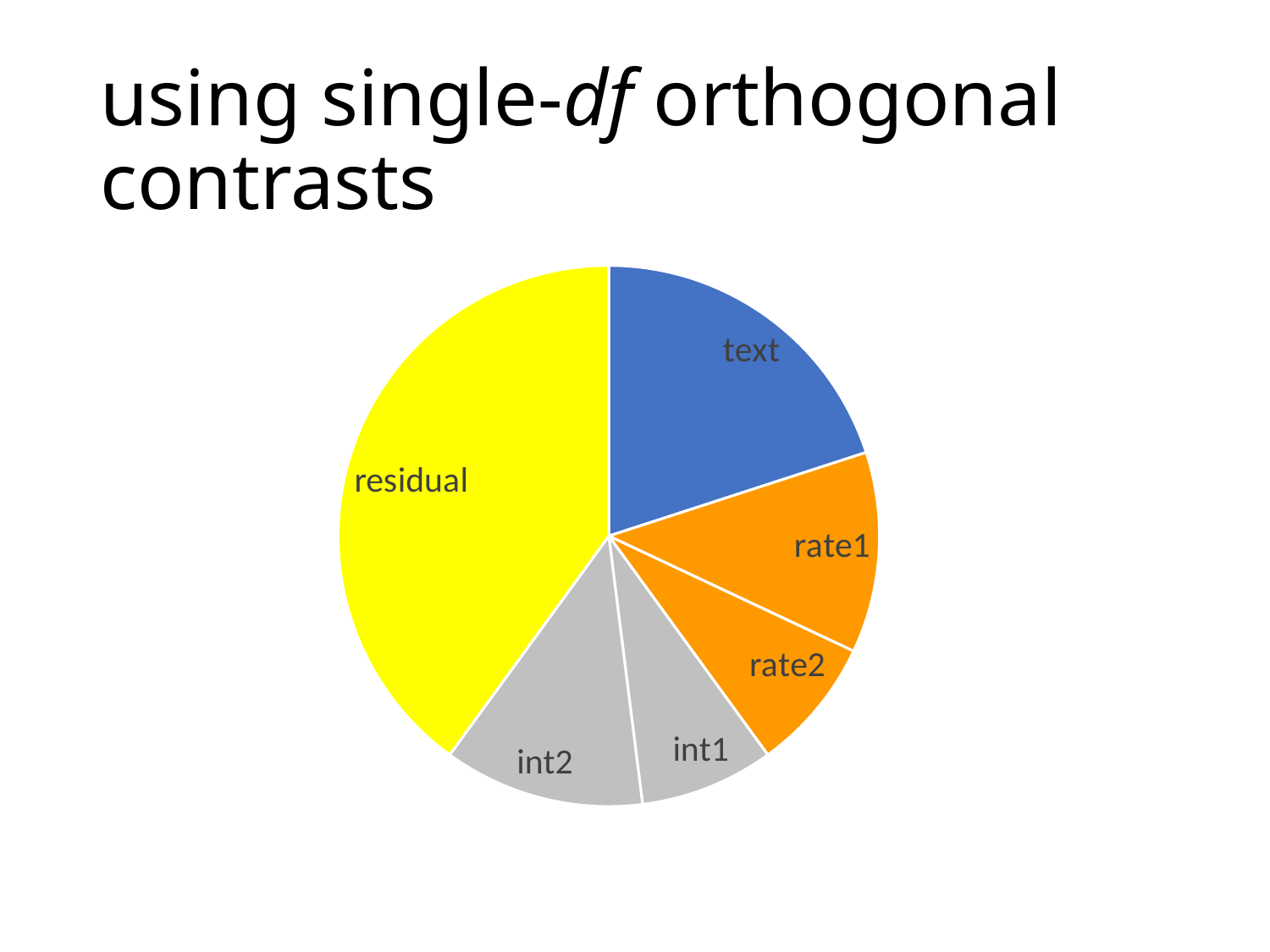
Which slice is larger, text or int1? text Which slice is larger, residual or text? residual Which slice is larger, text or rate1? text How many slices does the pie chart have? 6 Which slice of the pie chart is the largest? residual What colour is the residual slice of the pie chart? yellow What kind of chart is shown on the slide? pie chart Which two slices of the pie chart are coloured orange? rate1 and rate2